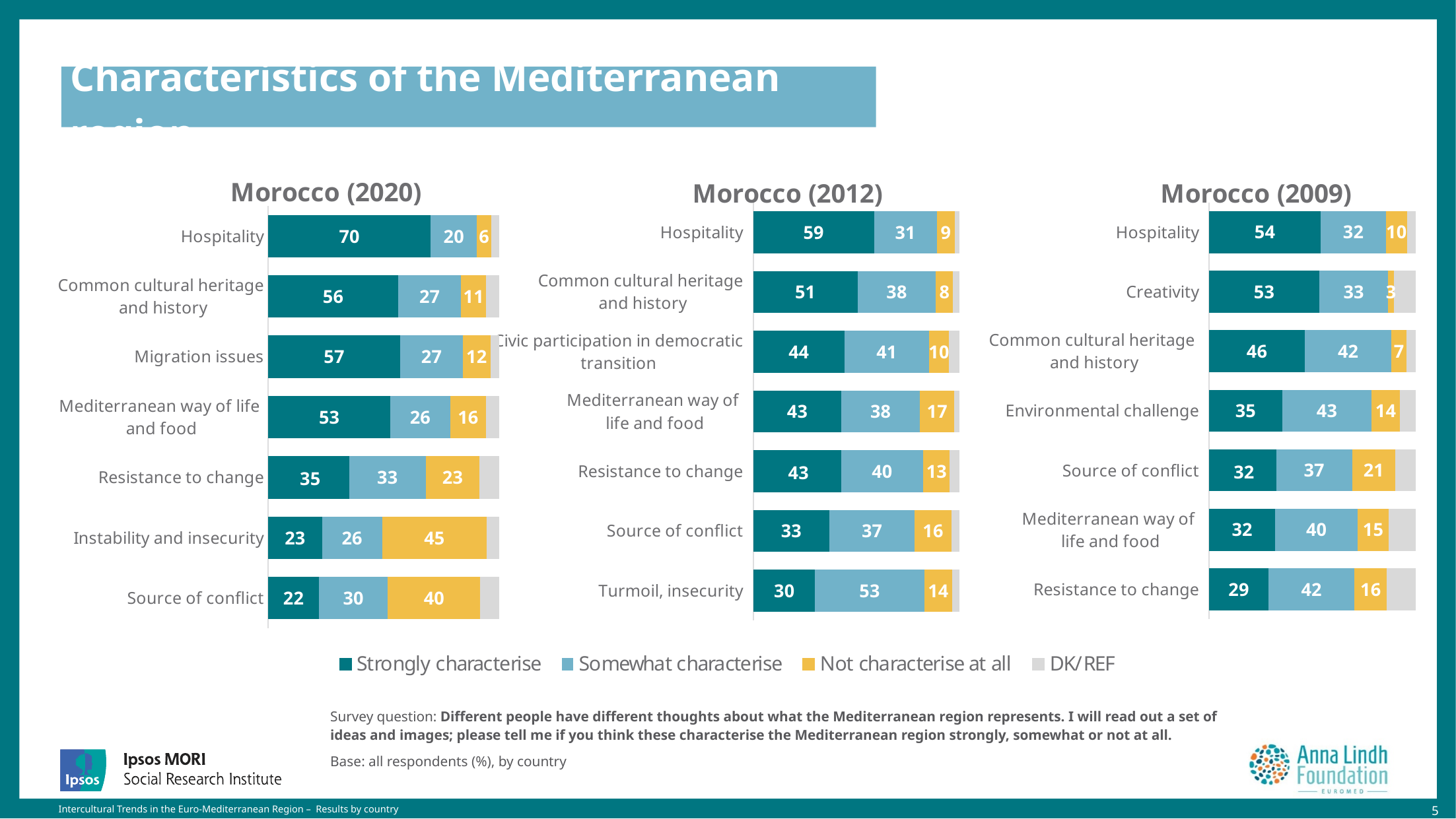
In the Morocco (2020) chart, what is the 'Strongly characterise' value for Hospitality? 70 In the Morocco (2009) chart, what is the difference between the 'Somewhat characterise' values for Environmental challenge and Hospitality? 11 How many categories are shown in the Morocco (2012) chart? 7 In the Morocco (2009) chart, what is the 'Not characterise at all' value for Source of conflict? 21 What kind of chart is the Morocco (2009) chart? Stacked bar chart How many series does the legend list? 4 Which legend entry is shown in yellow? Not characterise at all In the Morocco (2012) chart, what is the 'Somewhat characterise' value for Turmoil, insecurity? 53 In the Morocco (2012) chart, what is the difference between the 'Strongly characterise' values for Hospitality and Source of conflict? 26 In the Morocco (2020) chart, which is larger: the 'Strongly characterise' value for Migration issues or for Mediterranean way of life and food? Migration issues In the Morocco (2020) chart, which category has the highest 'Not characterise at all' value? Instability and insecurity In the Morocco (2009) chart, which category has the lowest 'Strongly characterise' value? Resistance to change